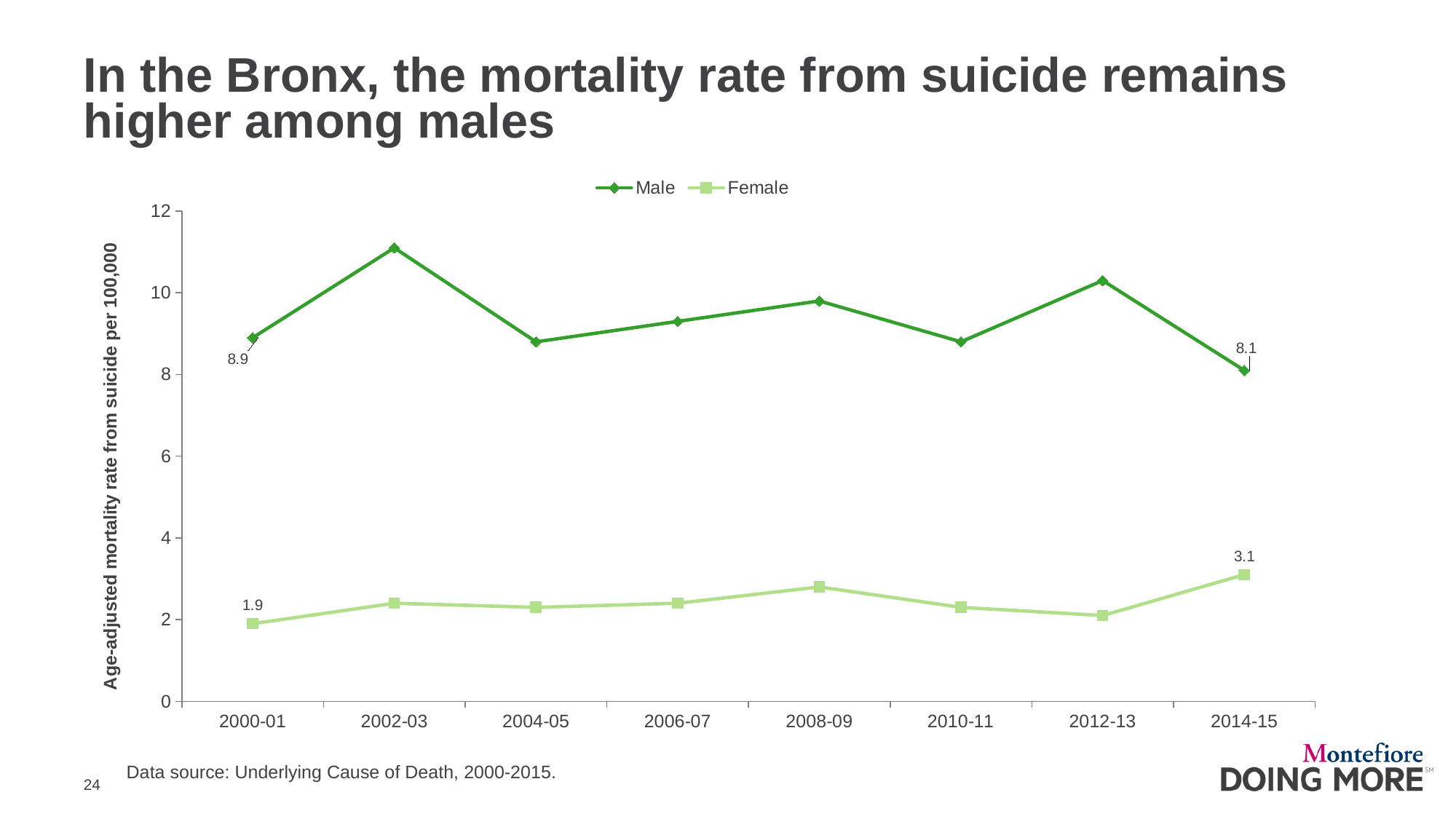
What is the difference between the Male and Female values in 2014-15? 5.0 What is the Male value for 2000-01? 8.9 What kind of chart is shown on the slide? line chart What is the Female value for 2014-15? 3.1 In which period is the Male value highest? 2002-03 By how much did the Male value fall from 2000-01 to 2014-15? 0.8 What is the Female value for 2000-01? 1.9 In which period is the Male value lowest? 2014-15 What is the Male value for 2014-15? 8.1 How many time periods are shown on the x axis? 8 Which series has the larger value in 2008-09, Male or Female? Male Is the Male value for 2002-03 greater or less than 10? greater